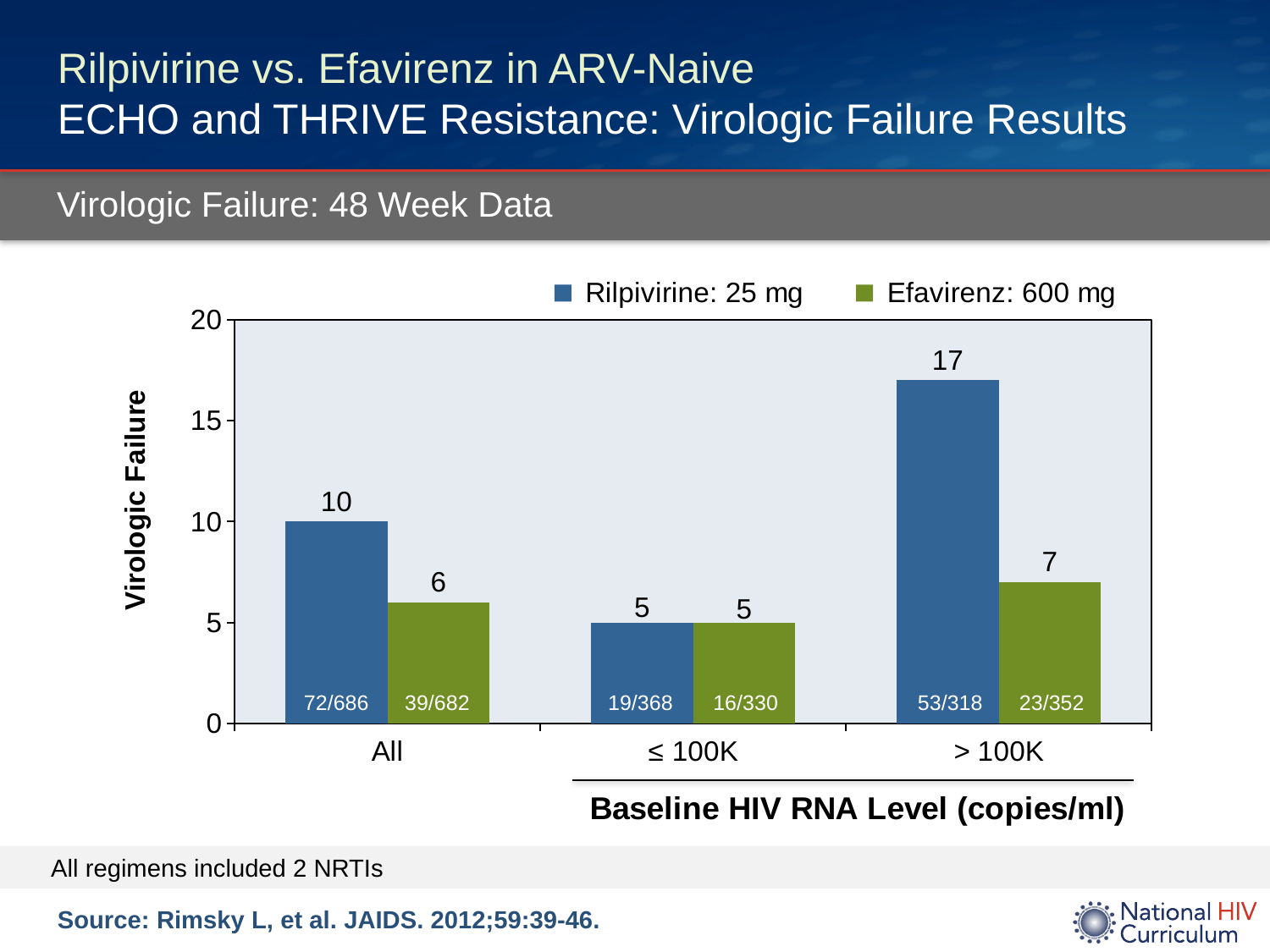
What kind of chart is shown on the slide? Bar chart Is the Rilpivirine: 25 mg value in the > 100K category greater or less than 15? greater What fraction is printed inside the Rilpivirine: 25 mg bar for the > 100K category? 53/318 What is the virologic failure value for Rilpivirine: 25 mg in the All category? 10 Which category has the lowest virologic failure value for Efavirenz: 600 mg? ≤ 100K What is the virologic failure value for Efavirenz: 600 mg in the > 100K category? 7 In the All category, which series has the larger virologic failure value, Rilpivirine: 25 mg or Efavirenz: 600 mg? Rilpivirine: 25 mg What is the virologic failure value for Rilpivirine: 25 mg in the ≤ 100K category? 5 Which category has the highest virologic failure value for Rilpivirine: 25 mg? > 100K How many series does the legend list? 2 What is the difference between the Rilpivirine: 25 mg and Efavirenz: 600 mg values in the > 100K category? 10 How many categories are shown on the x axis? 3